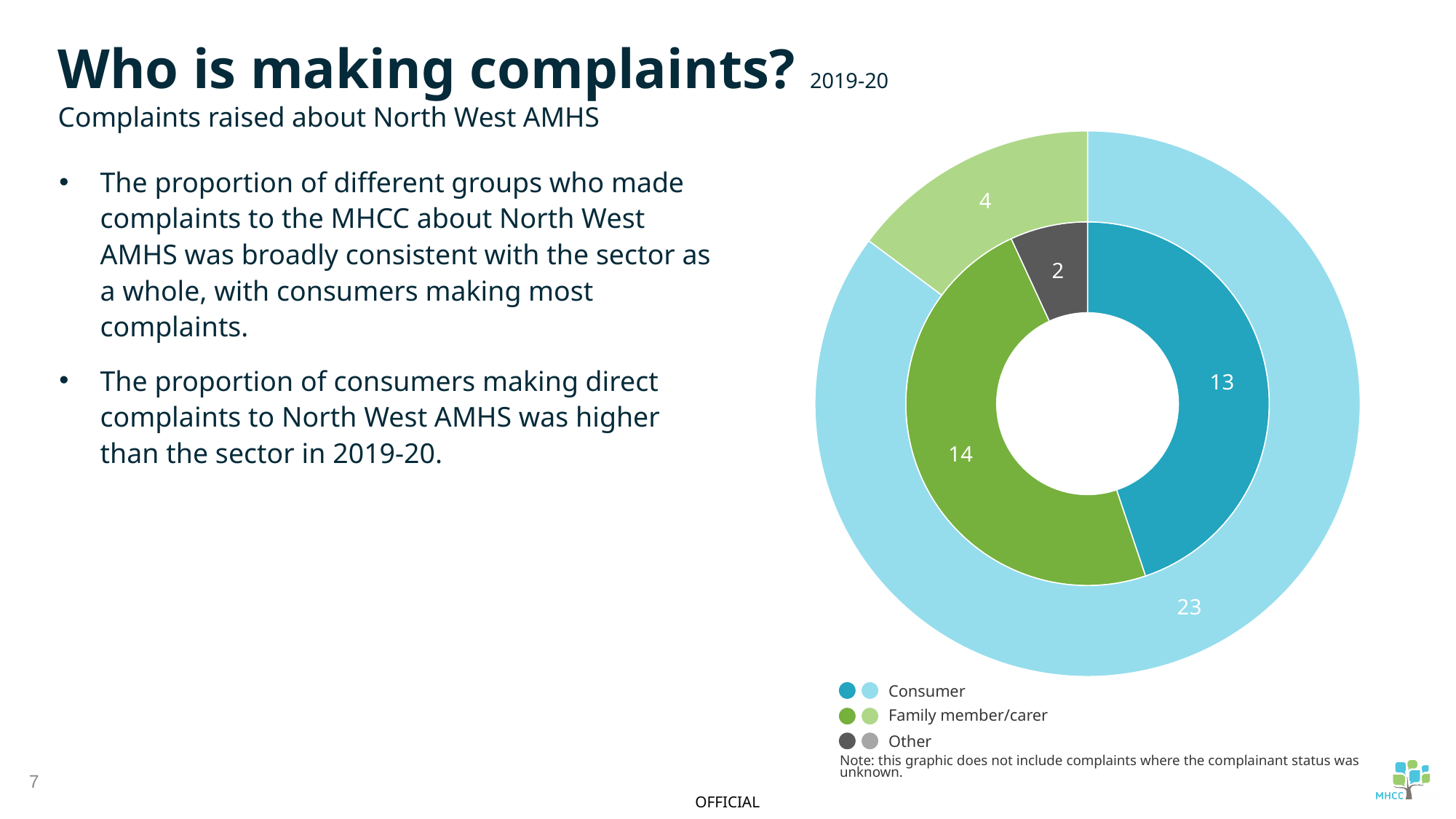
In the inner ring, which is larger: the Consumer value or the Family member/carer value? Family member/carer Which category has the smallest value in the inner ring of the chart? Other In the outer ring, what is the difference between the Consumer value and the Family member/carer value? 19 What is the value for Consumer in the inner ring of the chart? 13 What is the total of the three values in the inner ring of the chart? 29 What is the value for Consumer in the outer ring of the chart? 23 What is the value for Family member/carer in the outer ring of the chart? 4 What is the value for Family member/carer in the inner ring of the chart? 14 What kind of chart is shown on the slide? Doughnut chart What is the value for Other in the inner ring of the chart? 2 Which category has the largest value in the outer ring of the chart? Consumer How many categories does the chart legend list? 3